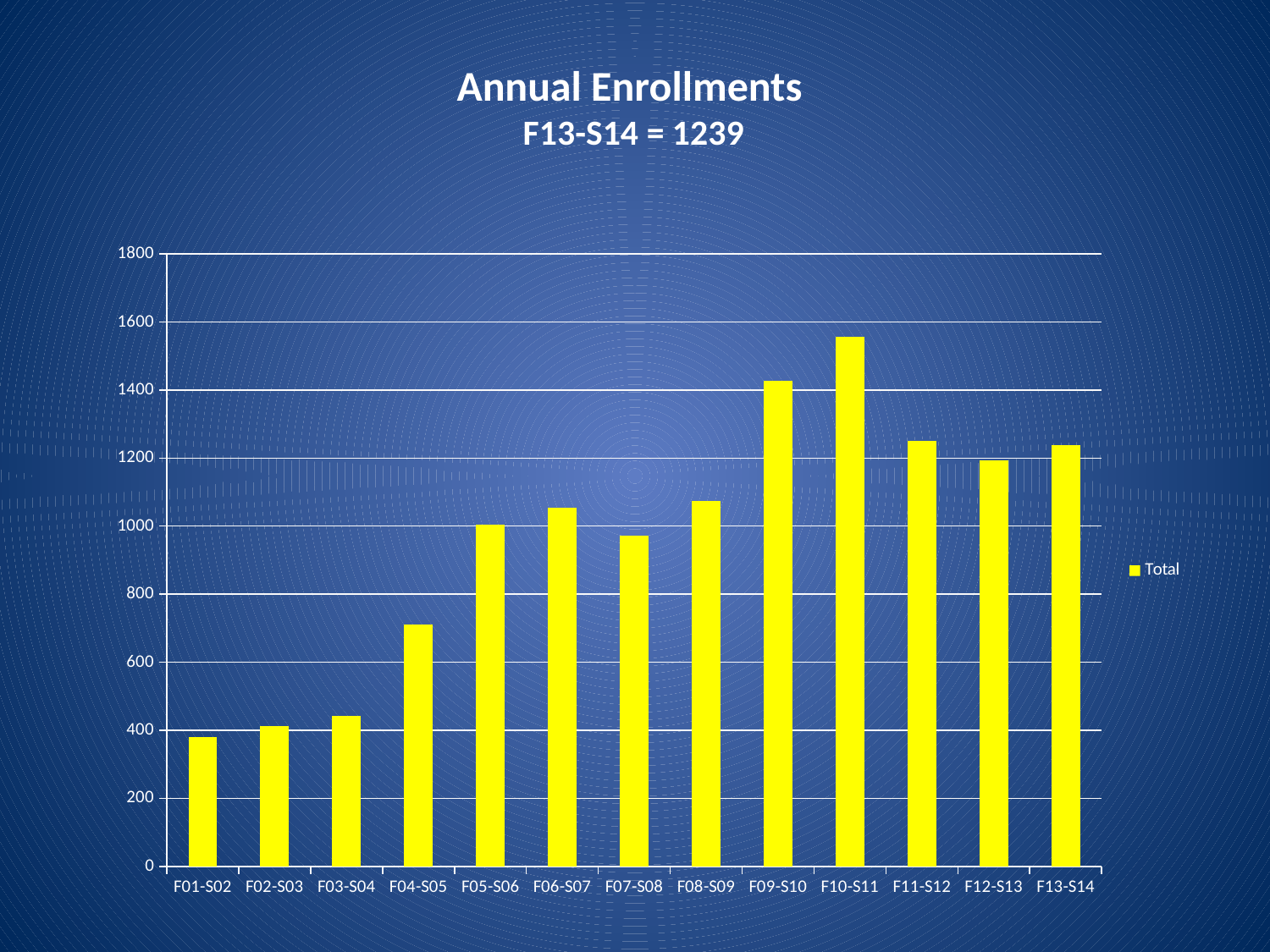
What is the name of the series shown in the legend? Total Is the value for F07-S08 greater or less than 1000? less What is the enrollment value for F13-S14? 1239 What type of chart is shown on the slide? bar chart Is the value for F04-S05 greater or less than 600? greater Do the values generally rise or fall from F01-S02 to F10-S11? rise Which academic year has the lowest enrollment? F01-S02 How many categories (academic years) are shown on the x axis? 13 Is the value for F10-S11 greater or less than 1600? less Which is larger, the value for F09-S10 or the value for F11-S12? F09-S10 Which academic year has the highest enrollment? F10-S11 How many series does the legend list? 1